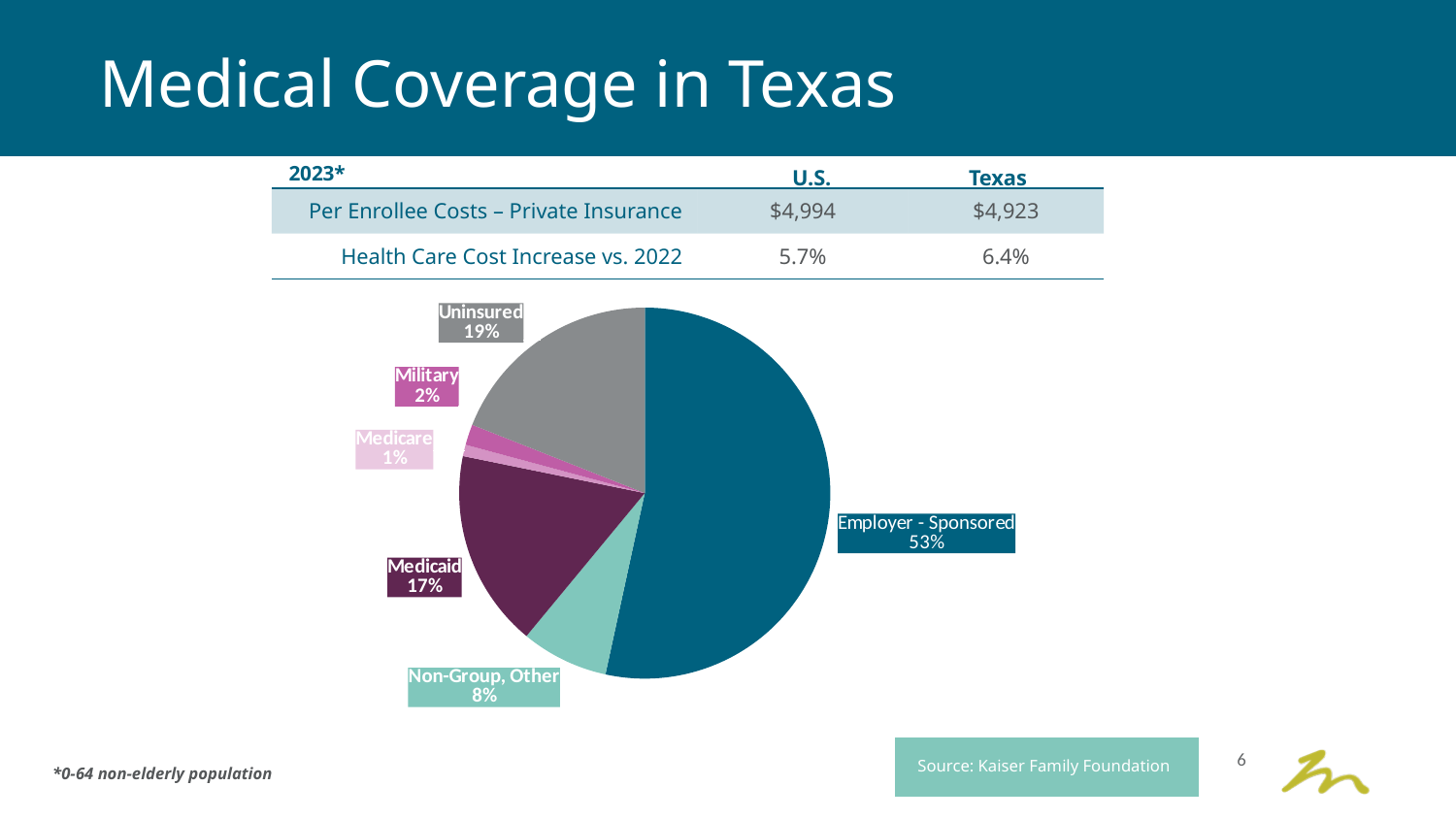
How many categories are shown in the pie chart? 6 What is the value for Medicaid in the pie chart? 17% Which category has the smallest slice of the pie? Medicare What is the value for Non-Group, Other in the pie chart? 8% Which category has the largest slice of the pie? Employer - Sponsored What share of the pie does Employer - Sponsored coverage represent? 53% What is the difference between the Uninsured and Medicaid shares? 2% What is the difference between the Employer - Sponsored share and the Uninsured share? 34% Which is larger, the Military slice or the Medicare slice? Military What source is cited for the data on the slide? Kaiser Family Foundation What is the value for Uninsured in the pie chart? 19% What kind of chart is shown on the slide? pie chart